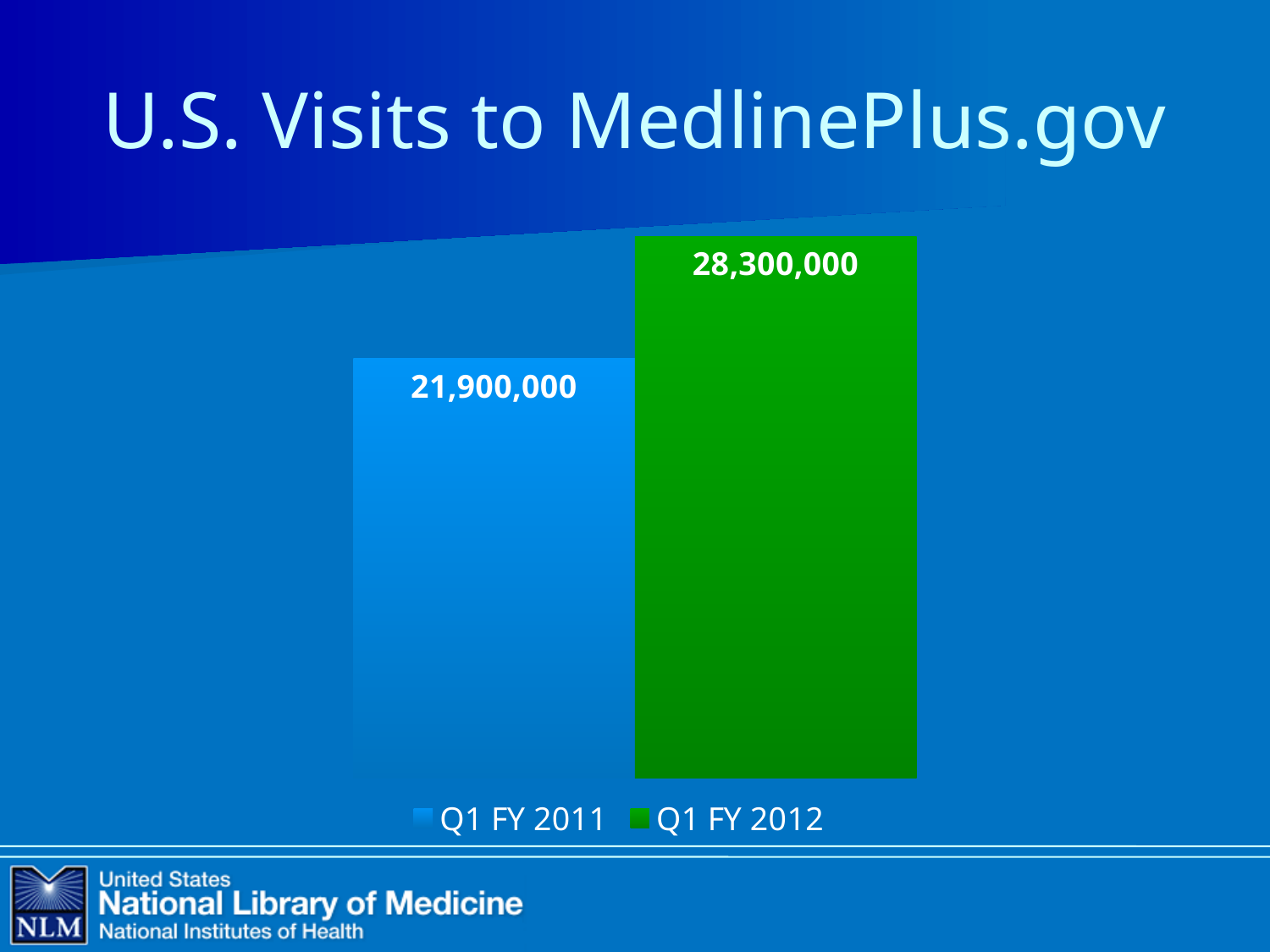
What is the value for Q1 FY 2011? 21,900,000 How many entries does the legend list? 2 What is the title of the slide? U.S. Visits to MedlinePlus.gov Which period has the lower number of visits? Q1 FY 2011 What colour is the bar for Q1 FY 2012? green Which period has the higher number of visits? Q1 FY 2012 What kind of chart is shown on the slide? bar chart How many bars are plotted in the chart? 2 What is the difference between the Q1 FY 2012 and Q1 FY 2011 values? 6,400,000 Do the values rise or fall from Q1 FY 2011 to Q1 FY 2012? rise What is the value for Q1 FY 2012? 28,300,000 Is the value for Q1 FY 2012 larger or smaller than the value for Q1 FY 2011? larger